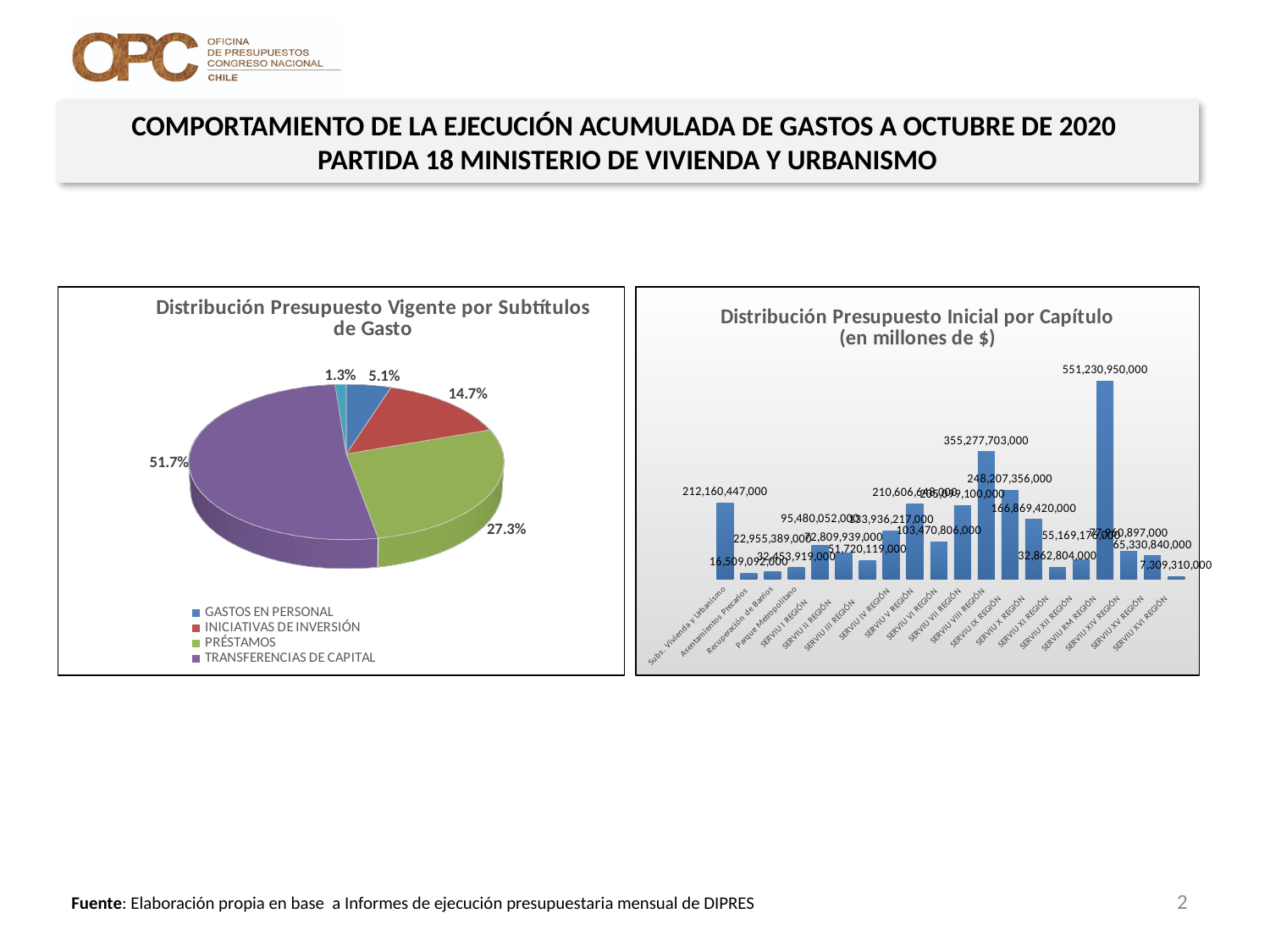
In the bar chart on the right, what is the value for SERVIU RM REGIÓN? 551,230,950,000 What kind of chart is the 'Distribución Presupuesto Inicial por Capítulo' chart on the right? Bar chart In the pie chart on the left, which legend category has the largest share? TRANSFERENCIAS DE CAPITAL In the pie chart on the left, what share does INICIATIVAS DE INVERSIÓN have? 14.7% In the pie chart on the left, how many percentage points larger is TRANSFERENCIAS DE CAPITAL than PRÉSTAMOS? 24.4 In the pie chart on the left, what share does TRANSFERENCIAS DE CAPITAL have? 51.7% What kind of chart is the 'Distribución Presupuesto Vigente por Subtítulos de Gasto' chart on the left? Pie chart In the bar chart on the right, which capítulo has the highest value? SERVIU RM REGIÓN In the bar chart on the right, which capítulo has the lowest value? SERVIU XVI REGIÓN In the bar chart on the right, what is the value for SERVIU VIII REGIÓN? 355,277,703,000 In the pie chart on the left, what share does PRÉSTAMOS have? 27.3% In the bar chart on the right, which is larger: SERVIU VIII REGIÓN or SERVIU IX REGIÓN? SERVIU VIII REGIÓN